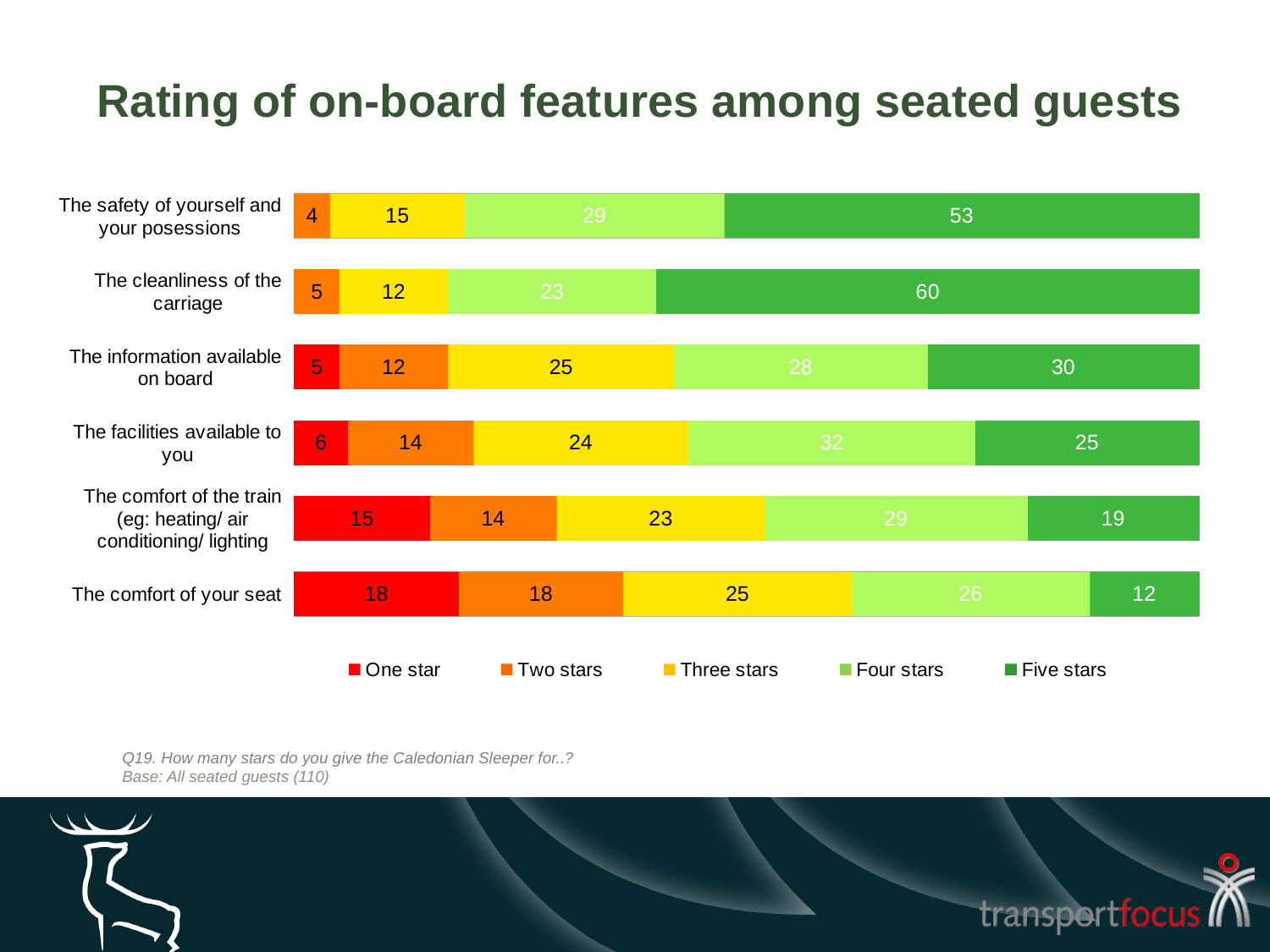
How many on-board features are shown in the chart? 6 Which feature has the highest five-star value? The cleanliness of the carriage What is the total of the stacked bar for the comfort of the train (eg: heating/ air conditioning/ lighting)? 100 What is the four-star value for the facilities available to you? 32 What is the difference between the five-star values for the cleanliness of the carriage and the safety of yourself and your possessions? 7 What kind of chart is shown on the slide? Stacked bar chart What percentage of seated guests gave five stars for the cleanliness of the carriage? 60 What is the one-star value for the comfort of your seat? 18 Which has a larger five-star value: the information available on board or the facilities available to you? The information available on board Which feature has the lowest five-star value? The comfort of your seat What is the five-star value for the comfort of your seat? 12 How many series does the legend list? 5